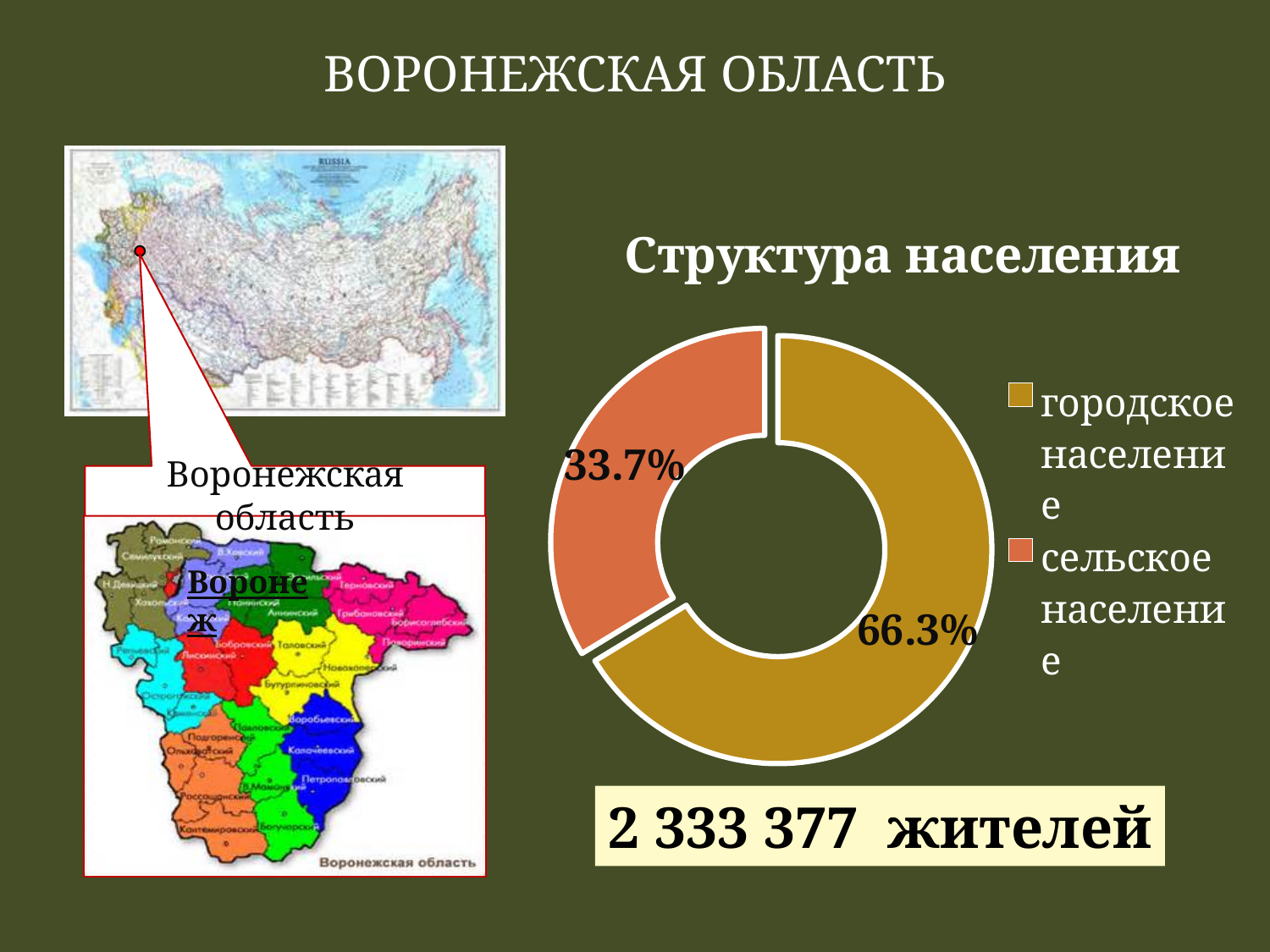
Which category has the smallest share in the "Структура населения" chart? сельское население By how many percentage points does городское население exceed сельское население in the "Структура населения" chart? 32.6 percentage points In the "Структура населения" chart, which is larger: городское население or сельское население? городское население What kind of chart is shown under the title "Структура населения"? doughnut (pie) chart What colour is the "сельское население" slice in the "Структура населения" chart? orange (terracotta) How many entries does the legend of the "Структура населения" chart list? 2 How many slices does the "Структура населения" chart have? 2 What share of the population is "городское население" in the "Структура населения" chart? 66.3% What share of the population is "сельское население" in the "Структура населения" chart? 33.7% Is the share of сельское население in the "Структура населения" chart greater or less than 50%? less Which category has the largest share in the "Структура населения" chart? городское население What is the title of the doughnut chart on the slide? Структура населения